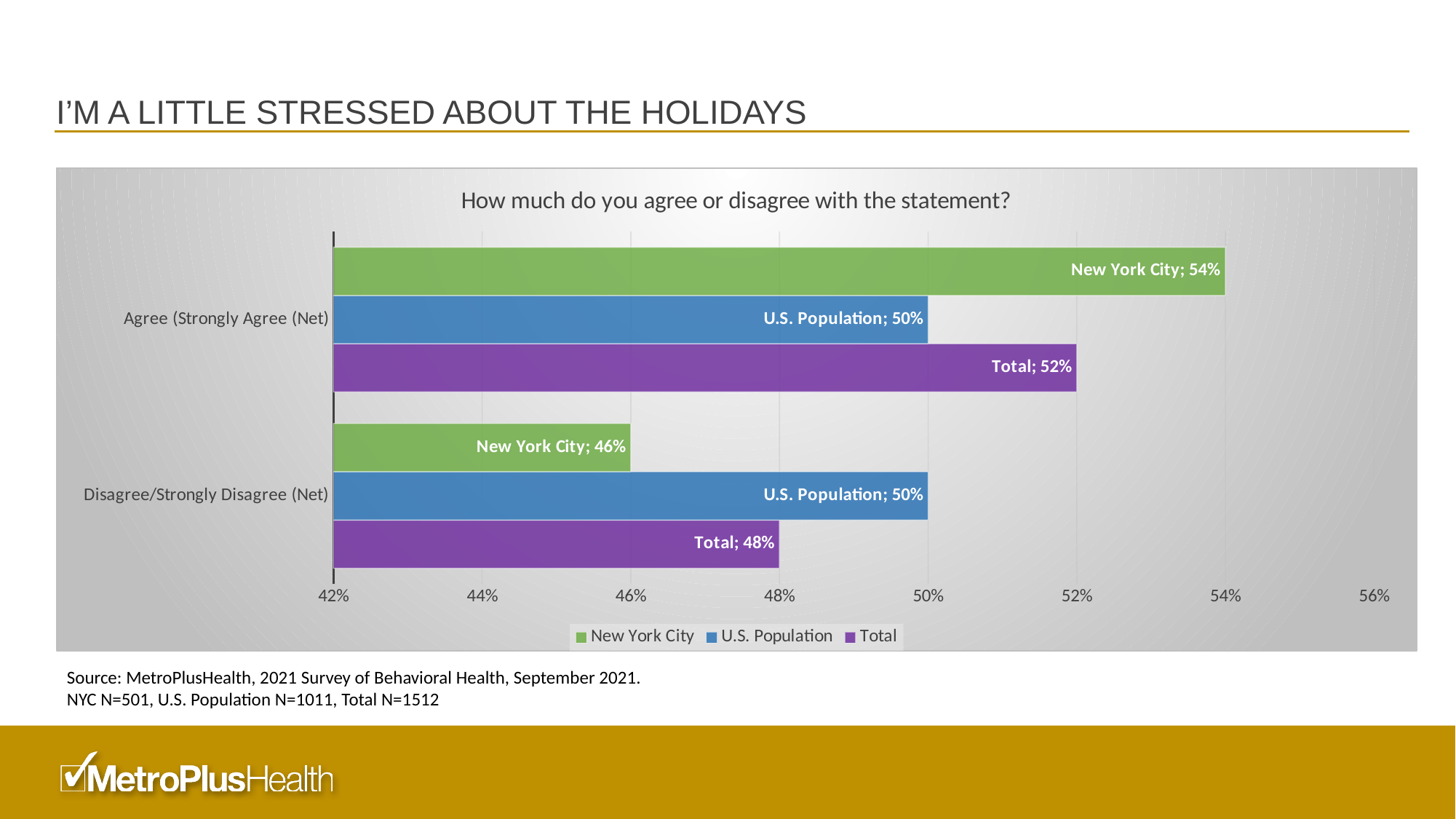
What is the difference between the New York City values for Agree (Strongly Agree (Net)) and Disagree/Strongly Disagree (Net)? 8% What is the value for U.S. Population in the Agree (Strongly Agree (Net)) category? 50% What is the value for Total in the Disagree/Strongly Disagree (Net) category? 48% How many series does the legend list? 3 Which series has the highest value in the Agree (Strongly Agree (Net)) category? New York City What is the value for New York City in the Agree (Strongly Agree (Net)) category? 54% What is the value for New York City in the Disagree/Strongly Disagree (Net) category? 46% What is the title of the chart? How much do you agree or disagree with the statement? How many categories are shown on the chart? 2 Which is larger: the Total value for Agree (Strongly Agree (Net)) or the Total value for Disagree/Strongly Disagree (Net)? Agree (Strongly Agree (Net)) What kind of chart is shown on the slide? Bar chart Which series has the lowest value in the Disagree/Strongly Disagree (Net) category? New York City